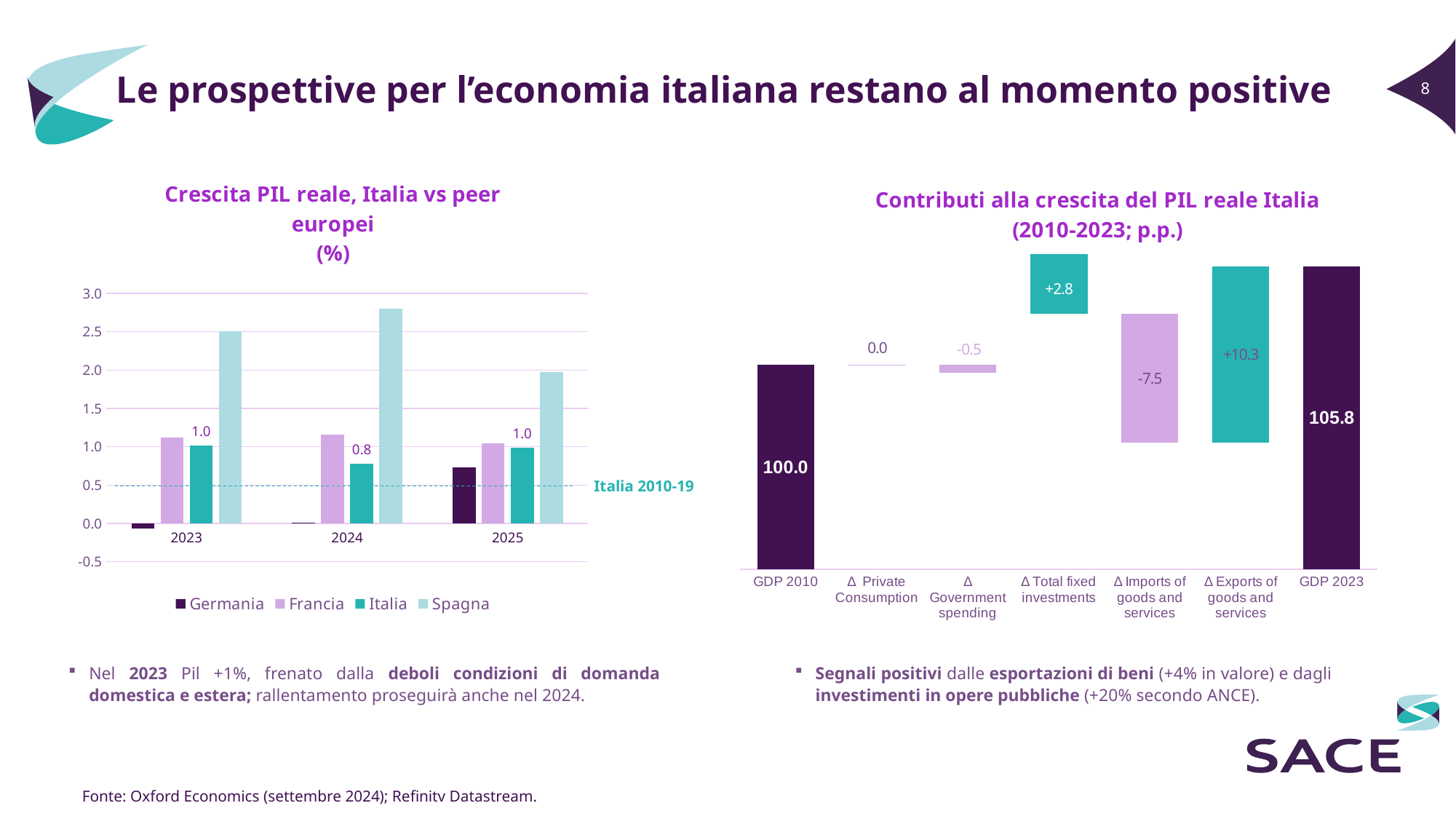
In the chart 'Crescita PIL reale, Italia vs peer europei (%)', is the value for Germania in 2025 greater or less than 1.0? less In the chart 'Contributi alla crescita del PIL reale Italia (2010-2023; p.p.)', which component has the lowest (most negative) value? Δ Imports of goods and services In the chart 'Crescita PIL reale, Italia vs peer europei (%)', what is the value for Italia in 2024? 0.8 In the chart 'Crescita PIL reale, Italia vs peer europei (%)', what is the value for Italia in 2025? 1.0 In the chart 'Crescita PIL reale, Italia vs peer europei (%)', which country has the highest value in 2024? Spagna In the chart 'Contributi alla crescita del PIL reale Italia (2010-2023; p.p.)', what is the value for GDP 2023? 105.8 In the chart 'Crescita PIL reale, Italia vs peer europei (%)', is the value for Spagna in 2024 greater or less than 2.5? greater What kind of chart is 'Crescita PIL reale, Italia vs peer europei (%)'? bar chart In the chart 'Crescita PIL reale, Italia vs peer europei (%)', how many series does the legend list? 4 In the chart 'Contributi alla crescita del PIL reale Italia (2010-2023; p.p.)', what is the value for Δ Exports of goods and services? +10.3 In the chart 'Crescita PIL reale, Italia vs peer europei (%)', is the value for Italia higher in 2023 or in 2024? 2023 In the chart 'Contributi alla crescita del PIL reale Italia (2010-2023; p.p.)', what is the difference between GDP 2023 and GDP 2010? 5.8